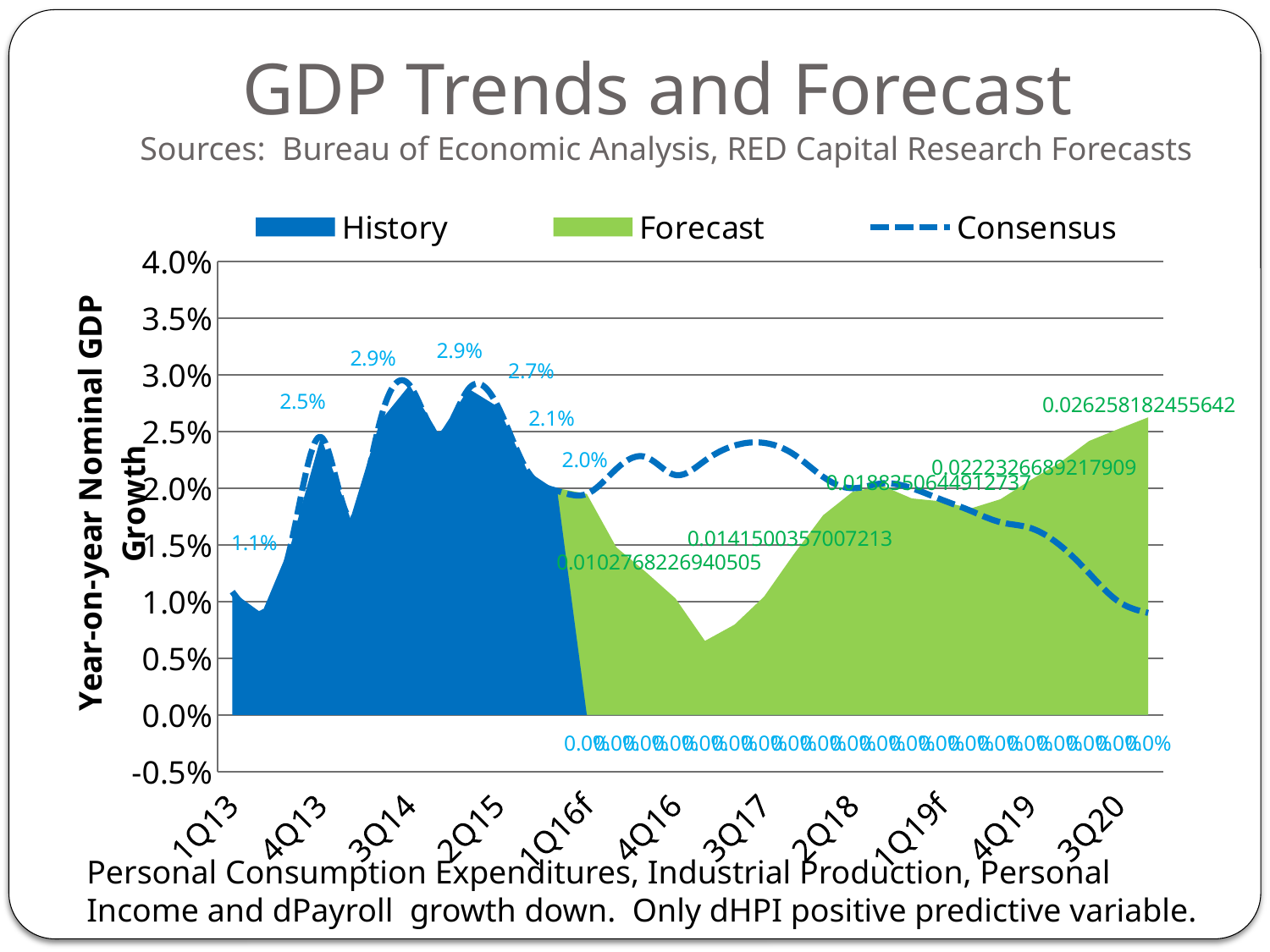
Is the Consensus value at 3Q20 greater or less than 1.5%? less What are the three entries in the chart legend? History, Forecast, Consensus What is the lowest value printed as a data label on the History series? 0.0% What is the first data label printed on the Forecast series, just after the History area ends? 0.0102768226940505 What is the last data label printed on the Forecast series, at the right end of the chart? 0.026258182455642 What kind of chart is shown on the slide? area chart How many series does the legend list? 3 What is the highest value printed as a data label on the History series? 2.9% How many quarter labels are shown on the x axis? 11 Which series is drawn as a dashed line? Consensus Does the Consensus line rise or fall between 2Q18 and 3Q20? fall What is the difference between the highest and lowest History data labels (2.9% and 1.1%)? 1.8%